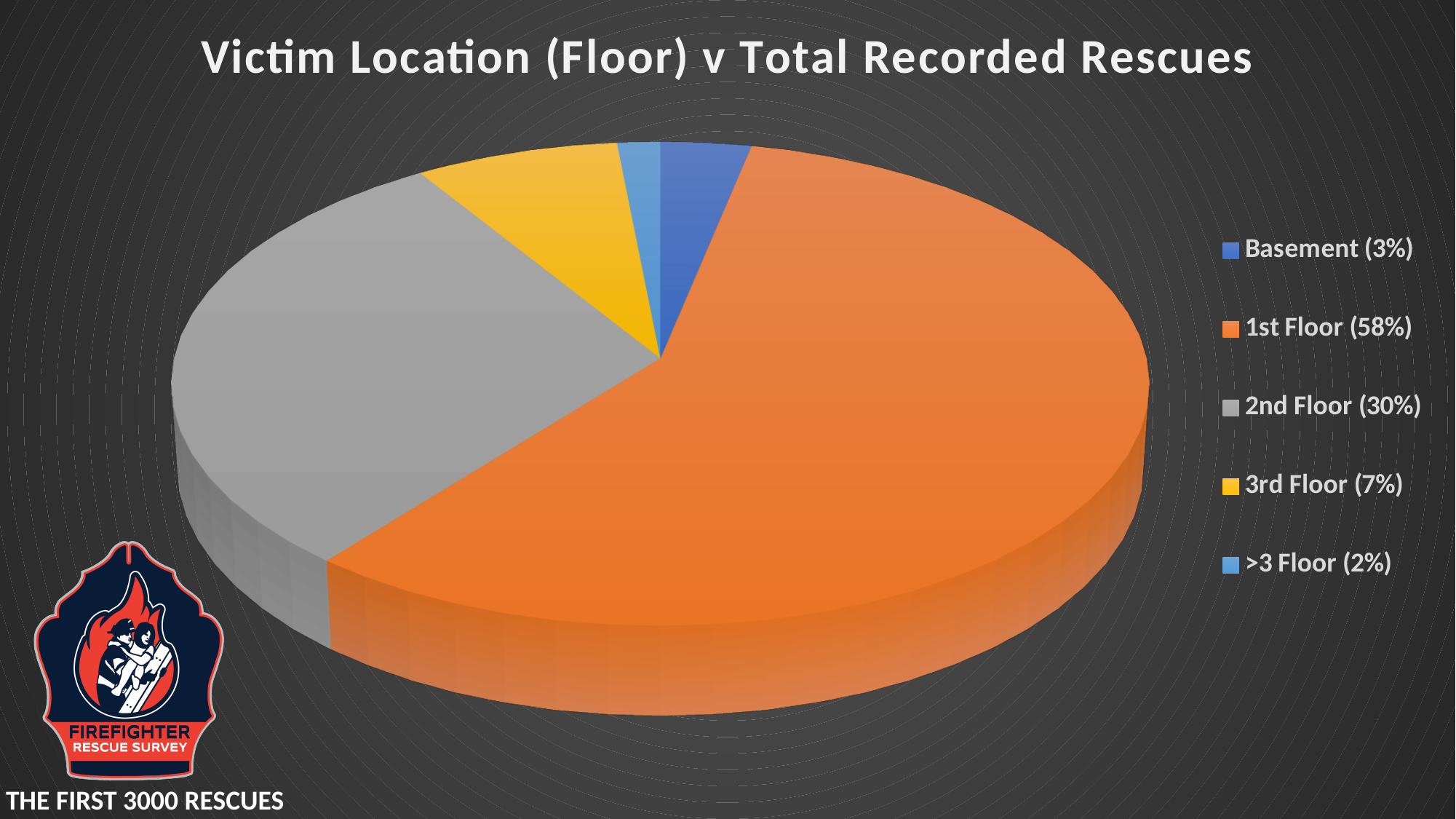
What share of total recorded rescues were on the 1st Floor? 58% What percentage of rescues were in the Basement? 3% What type of chart is shown on the slide? Pie chart What share of total recorded rescues were on the 2nd Floor? 30% How many percentage points larger is the 1st Floor share than the 2nd Floor share? 28 Which has a larger share of rescues, the Basement or the 3rd Floor? 3rd Floor What is the title of the chart? Victim Location (Floor) v Total Recorded Rescues What percentage of rescues were on floors above the 3rd (>3 Floor)? 2% Which victim location accounts for the smallest share of rescues? >3 Floor How many victim location categories does the pie chart show? 5 Which victim location accounts for the largest share of rescues? 1st Floor What percentage of rescues were on the 3rd Floor? 7%